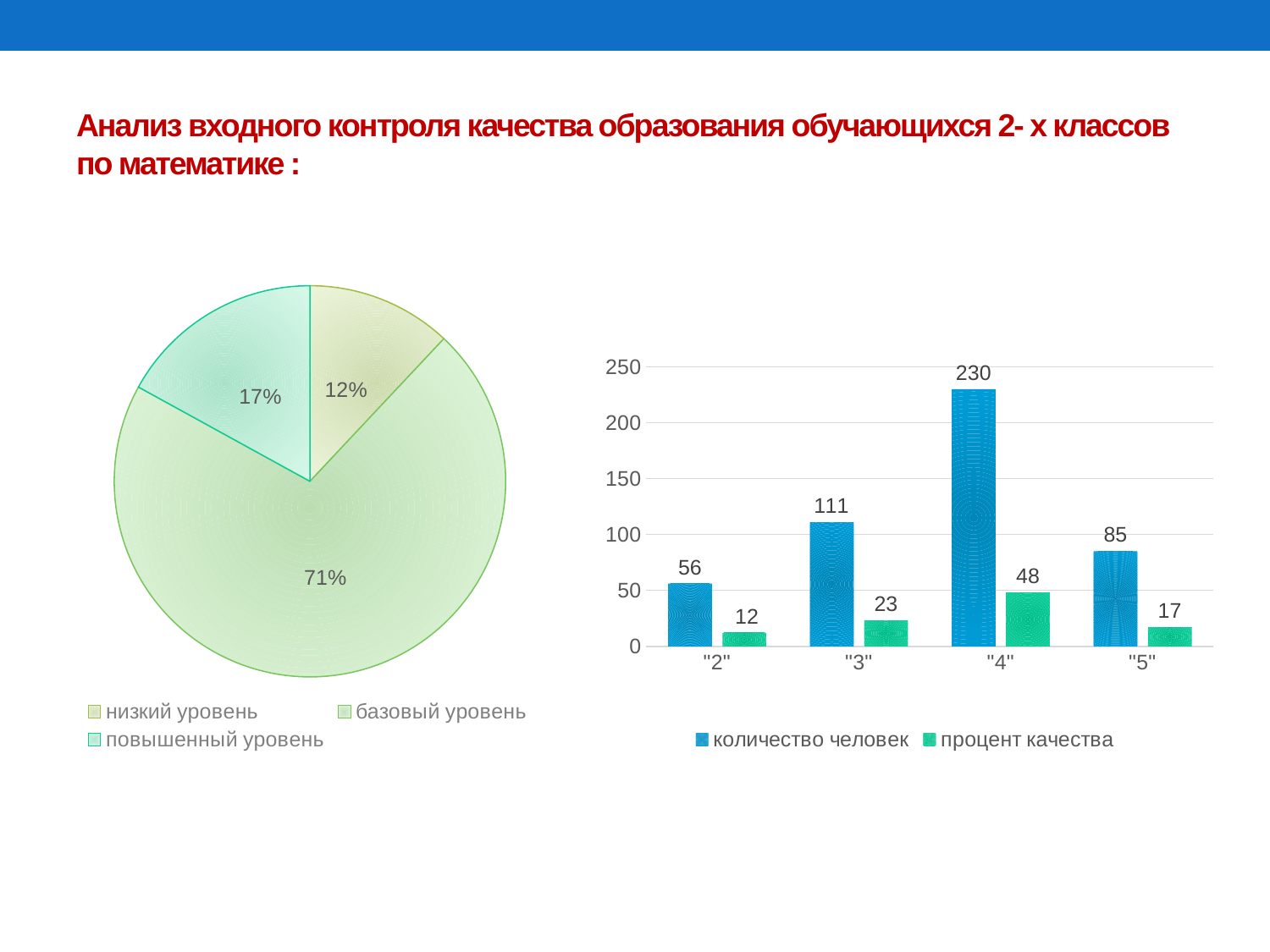
What type of chart is shown on the right side of the slide? bar chart In the bar chart on the right, what is the difference between количество человек for "3" and for "5"? 26 How many series does the legend of the bar chart on the right list? 2 In the pie chart on the left, which level has the smallest share? низкий уровень In the pie chart on the left, what share does повышенный уровень have? 17% In the pie chart on the left, what share does базовый уровень have? 71% In the bar chart on the right, which category has the highest количество человек? "4" In the bar chart on the right, is количество человек for "2" greater or less than 50? greater In the bar chart on the right, what is the value of процент качества for "3"? 23 How many slices does the pie chart on the left have? 3 In the bar chart on the right, which category has the lowest процент качества? "2" In the bar chart on the right, what is the value of количество человек for "4"? 230